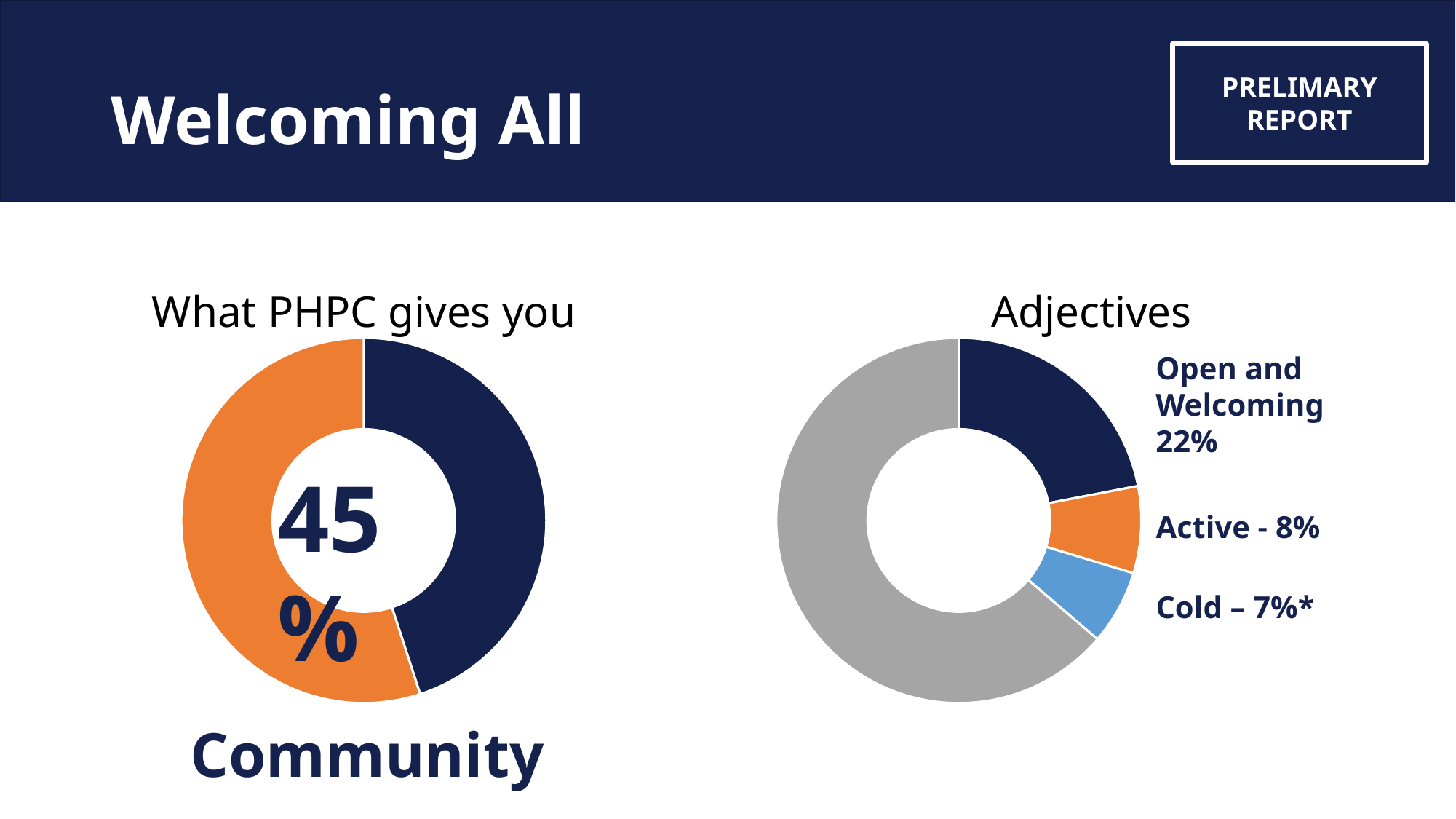
How many slices does the 'Adjectives' donut chart have? 4 In the 'Adjectives' chart, what percentage is shown for Cold? 7% In the 'Adjectives' chart, what percentage is shown for Active? 8% What kind of chart is the 'What PHPC gives you' chart on the left? Donut (pie) chart In the 'What PHPC gives you' chart, what percentage is shown for Community? 45% In the 'Adjectives' chart, what percentage is shown for Open and Welcoming? 22% In the 'Adjectives' chart, which of the labelled adjectives has the lowest percentage? Cold How many slices does the 'What PHPC gives you' donut chart have? 2 In the 'Adjectives' chart, what is the difference in percentage points between Open and Welcoming and Active? 14 In the 'Adjectives' chart, which of the labelled adjectives has the highest percentage? Open and Welcoming What is the title of the chart on the right side of the slide? Adjectives In the 'Adjectives' chart, which is larger, Open and Welcoming or Active? Open and Welcoming